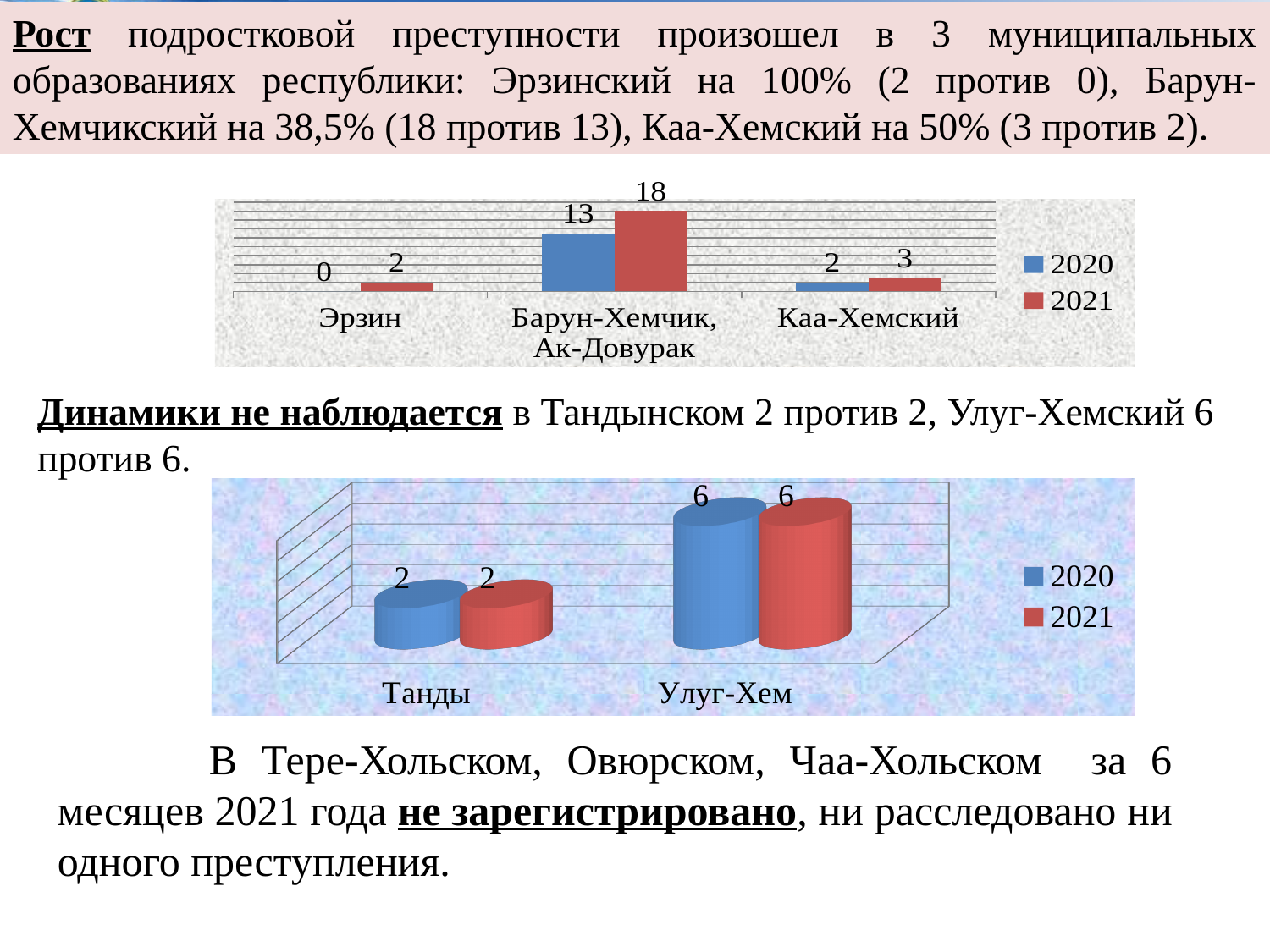
How many categories are shown in the top chart? 3 In the top chart, what is the difference between the 2021 and 2020 values for Барун-Хемчик, Ак-Довурак? 5 In the bottom chart, what is the 2021 value for Танды? 2 In the top chart, which category has the highest 2021 value? Барун-Хемчик, Ак-Довурак In the top chart, what is the 2021 value for Барун-Хемчик, Ак-Довурак? 18 In the bottom chart, what is the 2020 value for Улуг-Хем? 6 In the top chart, what is the 2020 value for Эрзин? 0 How many series does the legend of the bottom chart list? 2 In the top chart, which category has the lowest 2020 value? Эрзин In the top chart, what is the 2021 value for Каа-Хемский? 3 What kind of chart is the bottom chart? Bar chart In the top chart, which is larger for Каа-Хемский: the 2020 value or the 2021 value? 2021